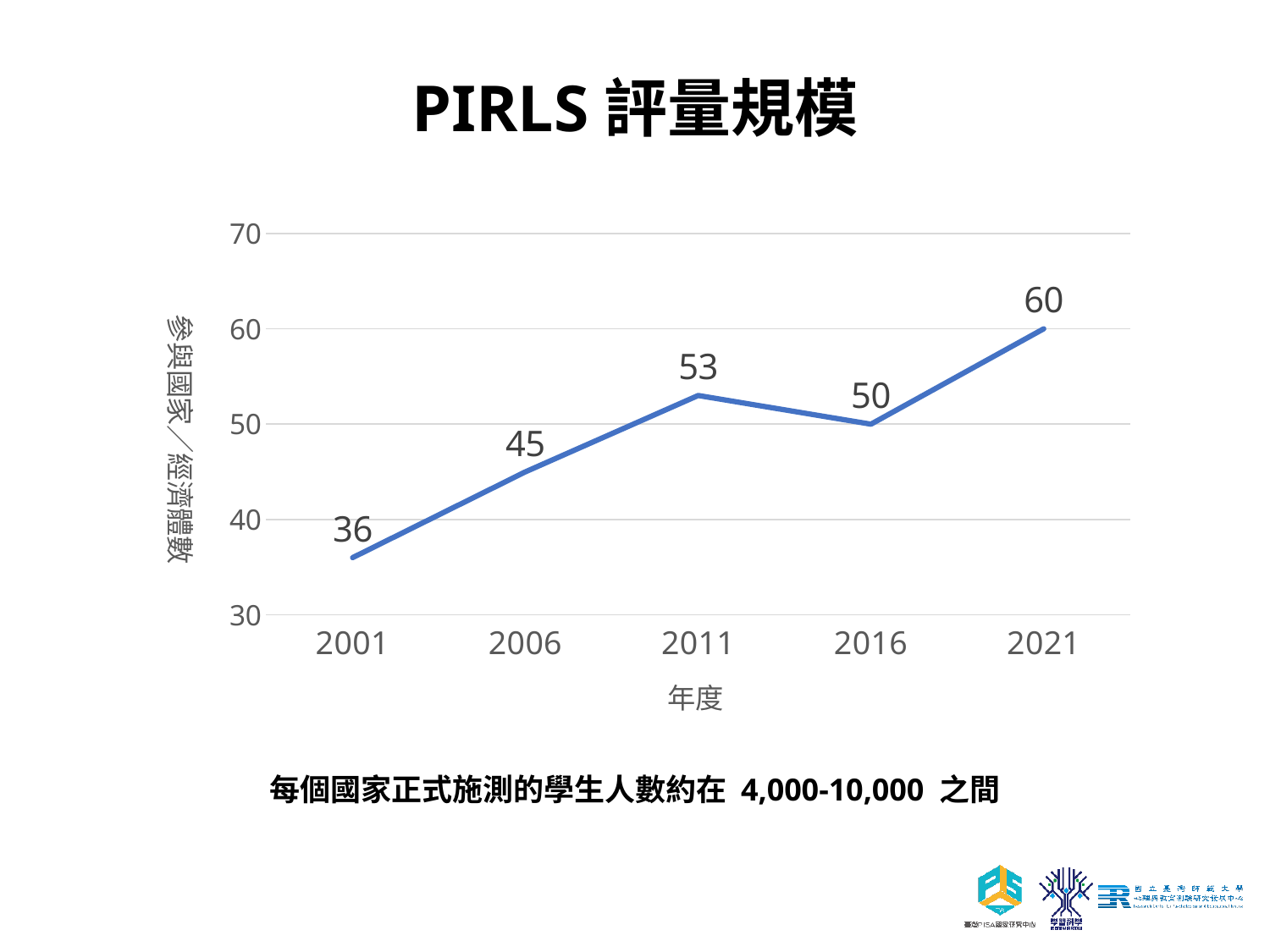
What is the title of the chart? PIRLS 評量規模 What is the value for 2001? 36 Which is larger, the value for 2006 or the value for 2016? 2016 What is the difference between the values for 2011 and 2016? 3 What is the value for 2011? 53 What is the value for 2016? 50 Does the value rise or fall from 2011 to 2016? fall Which year has the lowest value? 2001 What type of chart is shown on the slide? line chart Which year has the highest value? 2021 What is the difference between the values for 2021 and 2001? 24 How many years are plotted on the x axis? 5